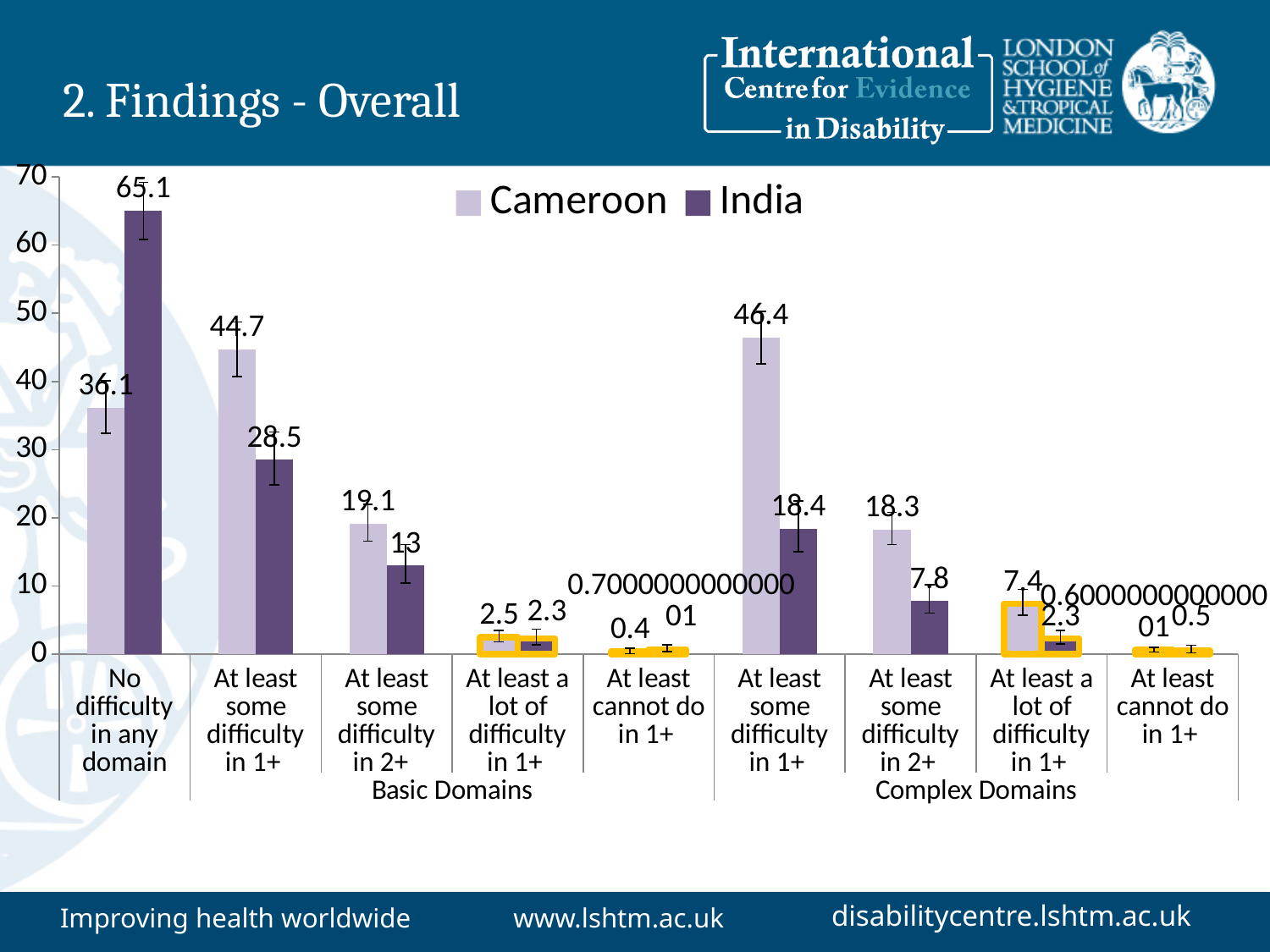
What kind of chart is shown on the slide? Bar chart Which is larger for 'At least a lot of difficulty in 1+' in the Complex Domains group, Cameroon or India? Cameroon What is the value for India for 'At least some difficulty in 2+' in the Complex Domains group? 7.8 What is the difference between Cameroon and India for 'At least some difficulty in 1+' in the Basic Domains group? 16.2 How many series does the legend list? 2 What is the value for Cameroon for 'At least some difficulty in 1+' in the Complex Domains group? 46.4 What is the value for India for 'At least some difficulty in 2+' in the Basic Domains group? 13 What is the value for Cameroon for 'No difficulty in any domain'? 36.1 What is the value for India for 'No difficulty in any domain'? 65.1 What is the difference between India and Cameroon for 'No difficulty in any domain'? 29 Which category has the highest value for Cameroon? At least some difficulty in 1+ (Complex Domains) Which category has the highest value for India? No difficulty in any domain